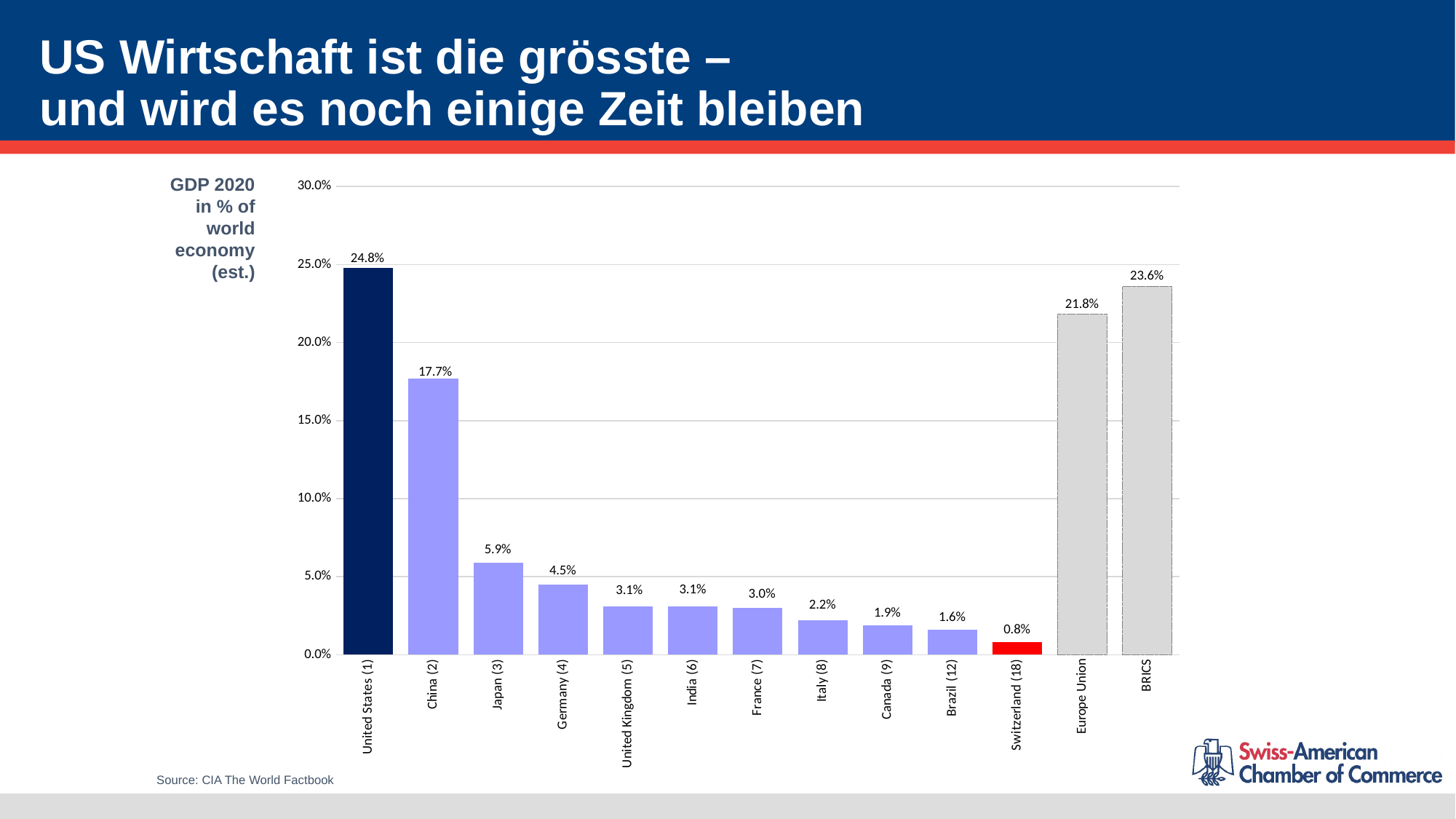
Which category has the lowest value? Switzerland (18) Which category has the highest value? United States (1) How many categories are shown on the x axis? 13 What kind of chart is shown on the slide? Bar chart What is the value for Switzerland (18)? 0.8% Which is larger, the value for Europe Union or the value for BRICS? BRICS What is the value for BRICS? 23.6% What is the difference between the values for Japan (3) and Germany (4)? 1.4% What is the value for United States (1)? 24.8% What is the value for China (2)? 17.7% Which bar is coloured red? Switzerland (18) What is the difference between the values for United States (1) and China (2)? 7.1%